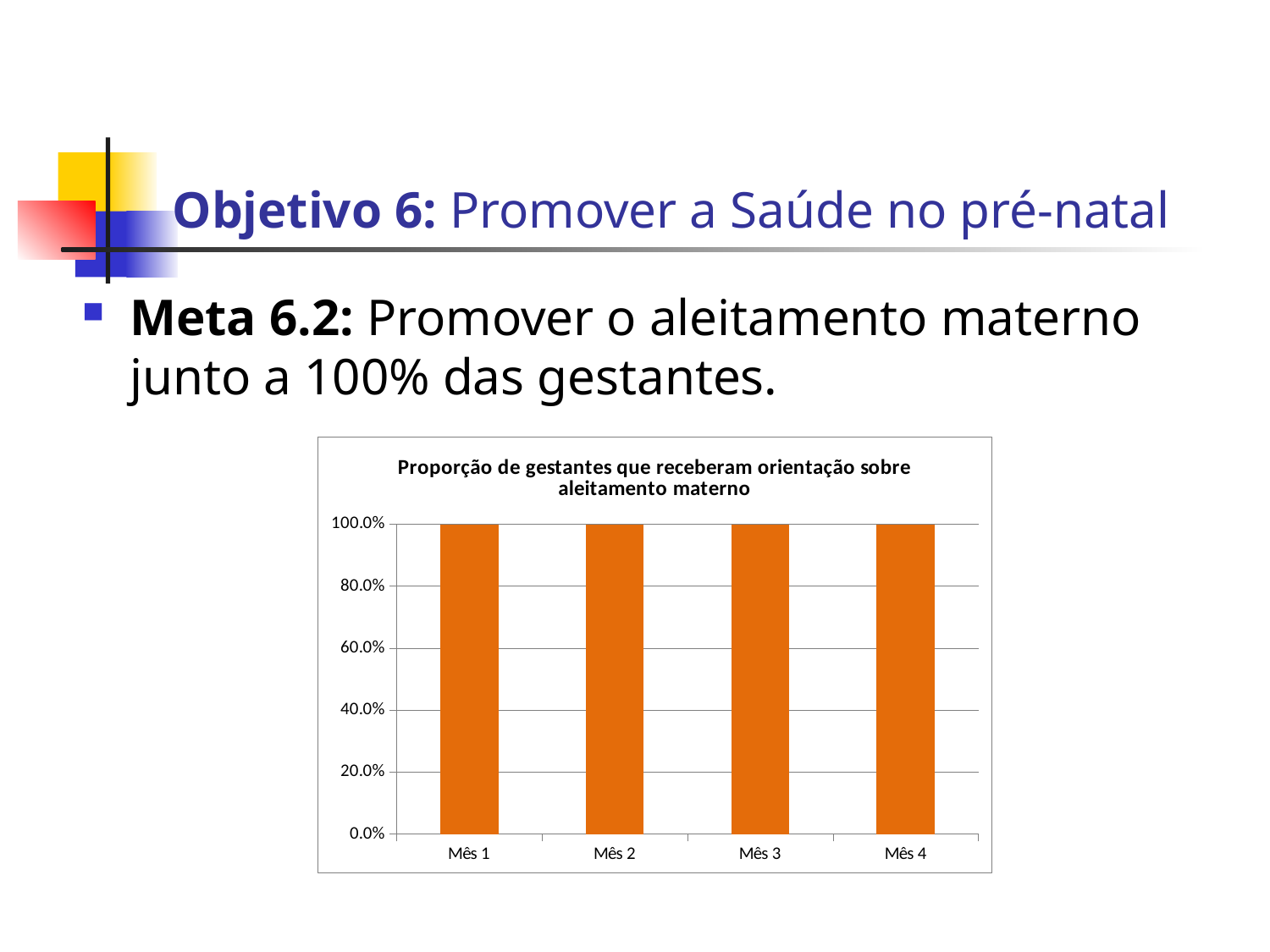
What is the title of the chart? Proporção de gestantes que receberam orientação sobre aleitamento materno What is the value for Mês 3 in the chart? 100.0% What type of chart is shown on the slide? Bar chart What is the value for Mês 1 in the chart? 100.0% What is the label of the first category on the x axis? Mês 1 What is the difference between the values for Mês 1 and Mês 4? 0.0% What colour are the bars in the chart? Orange What is the value for Mês 4 in the chart? 100.0% Do the values rise, fall, or stay flat from Mês 1 to Mês 4? stay flat How many categories (months) are shown on the x axis of the chart? 4 Is the value for Mês 2 greater or less than 80.0%? greater